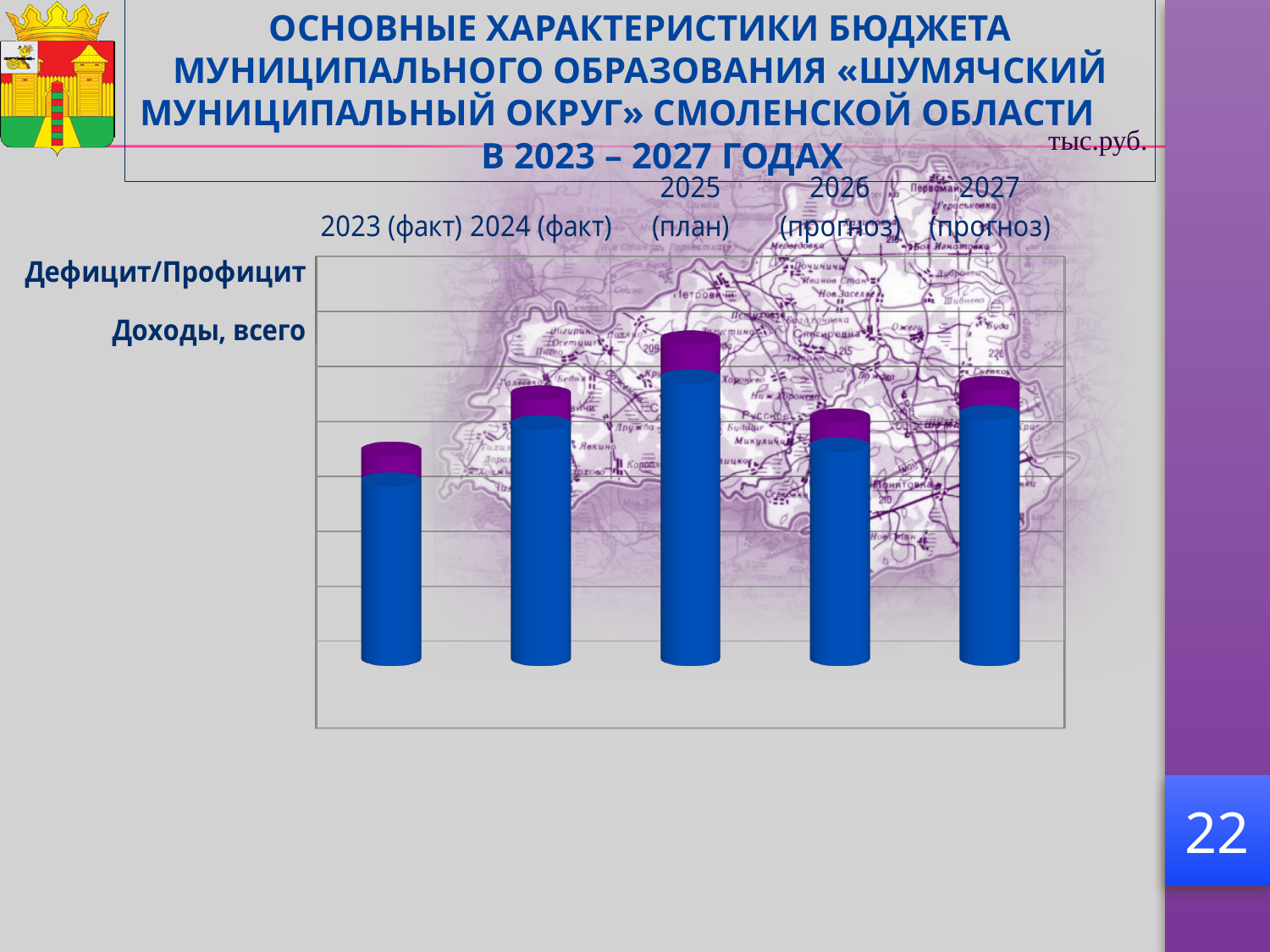
What are the two series names listed next to the chart? Дефицит/Профицит; Доходы, всего Which bar is taller, 2023 (факт) or 2026 (прогноз)? 2026 (прогноз) What kind of chart is shown on the slide? bar chart What unit of measurement is indicated for the chart? тыс.руб. Which bar is taller, 2026 (прогноз) or 2027 (прогноз)? 2027 (прогноз) Do the bar heights rise or fall from 2025 (план) to 2026 (прогноз)? fall Which year has the shortest bar on the chart? 2023 (факт) How many year categories are plotted on the chart? 5 Which bar is taller, 2024 (факт) or 2026 (прогноз)? 2024 (факт) Do the bar heights rise or fall from 2023 (факт) to 2025 (план)? rise Which year has the tallest bar on the chart? 2025 (план)